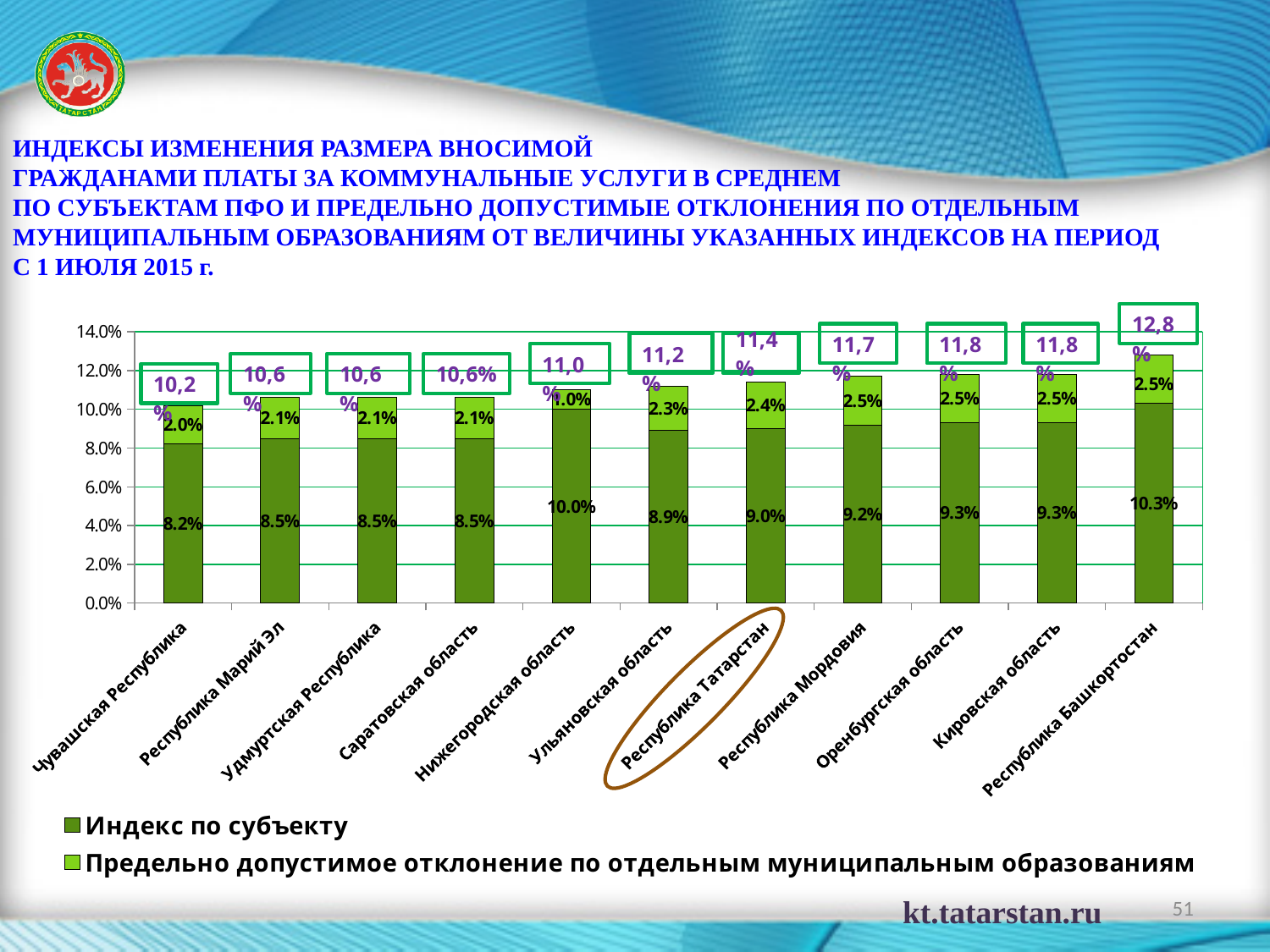
Which region has the lowest value of 'Предельно допустимое отклонение по отдельным муниципальным образованиям'? Нижегородская область Which is larger: the 'Индекс по субъекту' value for Нижегородская область or for Республика Мордовия? Нижегородская область What type of chart is shown on the slide? stacked bar chart What is the value of 'Индекс по субъекту' for Республика Татарстан? 9.0% Which region has the highest value of 'Индекс по субъекту'? Республика Башкортостан How many regions (categories) are shown on the x axis of the chart? 11 How many series does the chart legend list? 2 What is the total of the stacked bar for Республика Башкортостан, as labelled above the bar? 12,8% Which region on the x axis is circled on the chart? Республика Татарстан What is the value of 'Предельно допустимое отклонение по отдельным муниципальным образованиям' for Нижегородская область? 1.0% What is the difference between the 'Индекс по субъекту' values for Республика Башкортостан and Чувашская Республика? 2.1% What is the value of 'Индекс по субъекту' for Чувашская Республика? 8.2%